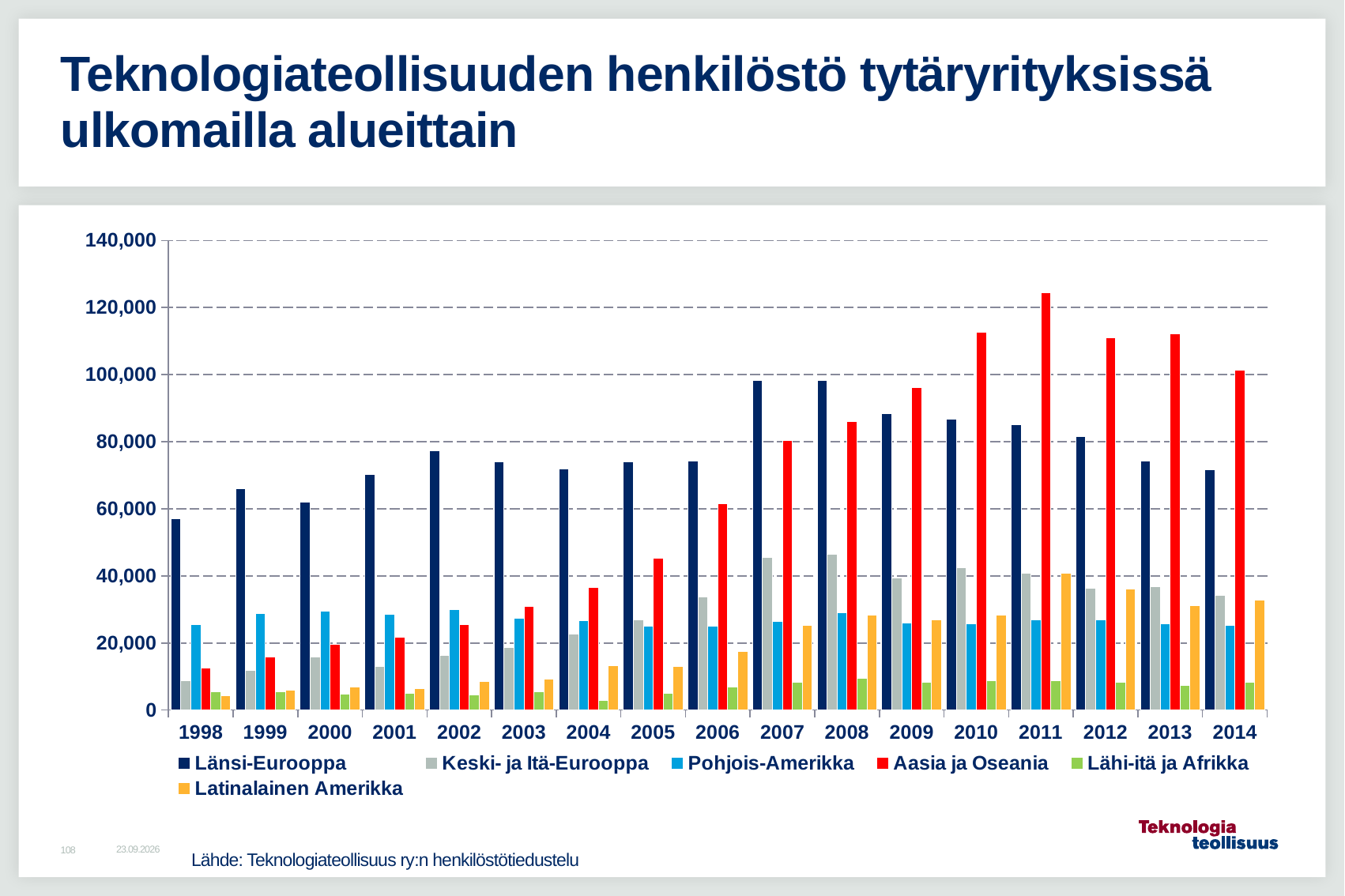
Is the value for Länsi-Eurooppa in 2007 greater or less than 80,000? greater In 2014, which is larger: Aasia ja Oseania or Länsi-Eurooppa? Aasia ja Oseania What kind of chart is shown on the slide? bar chart In which year is the value for Aasia ja Oseania lowest? 1998 Is the value for Aasia ja Oseania in 2011 greater or less than 120,000? greater In which year is the value for Aasia ja Oseania highest? 2011 Is the value for Latinalainen Amerikka in 2011 greater or less than 20,000? greater How many series does the legend list? 6 In 1998, which is larger: Länsi-Eurooppa or Aasia ja Oseania? Länsi-Eurooppa Do the values for Aasia ja Oseania generally rise or fall from 1998 to 2011? rise How many years are shown on the x axis? 17